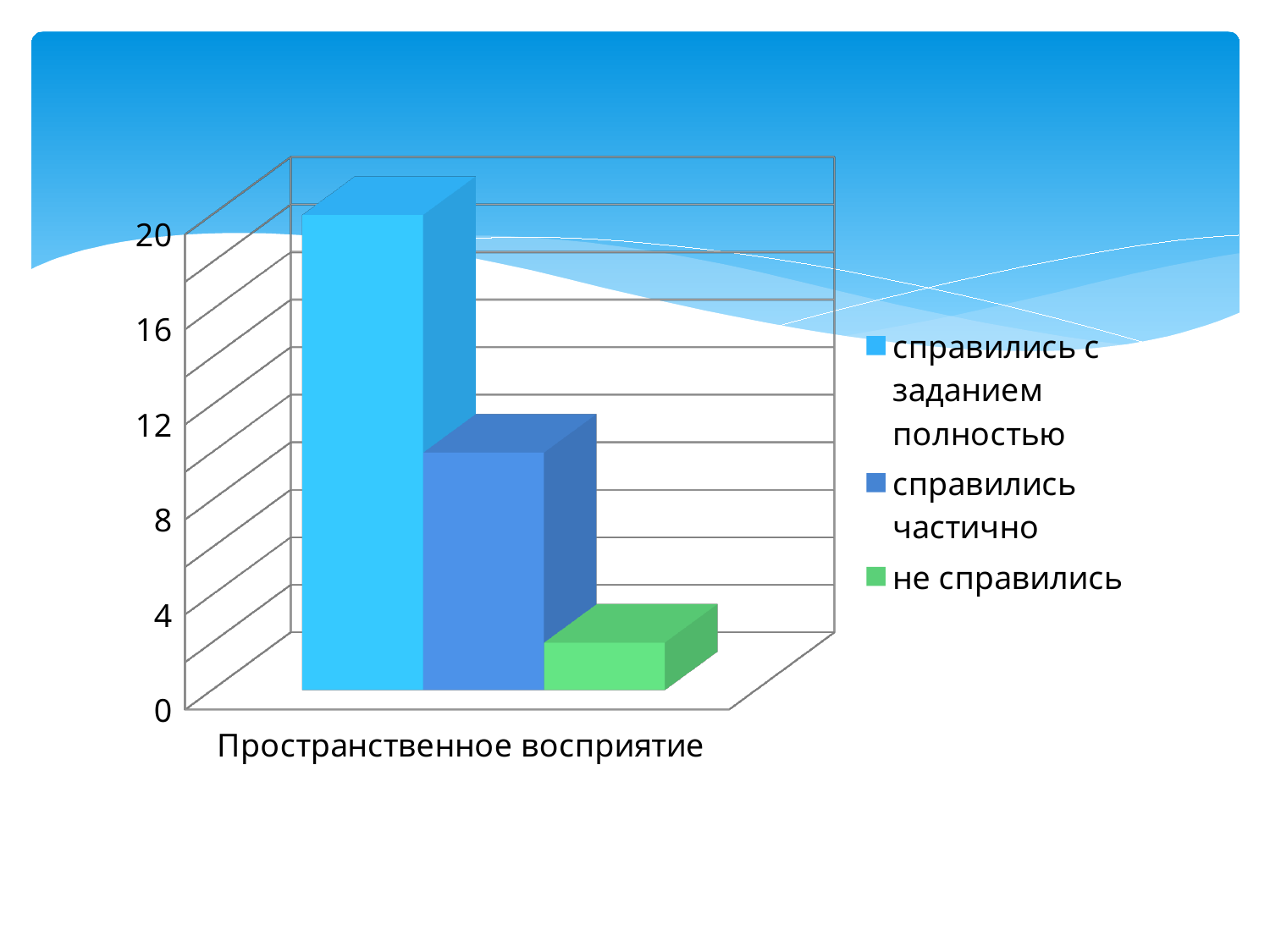
Is the value for "справились частично" greater or less than 12? less Which is larger: the value for "справились с заданием полностью" or the value for "справились частично"? справились с заданием полностью Which series has the lowest value? не справились What is the category label shown on the x axis? Пространственное восприятие How many categories are shown on the x axis? 1 How many series does the legend list? 3 Which is larger: the value for "справились частично" or the value for "не справились"? справились частично What kind of chart is shown on the slide? bar chart Is the value for "справились частично" greater or less than 8? greater Which series has the highest value? справились с заданием полностью Is the value for "справились с заданием полностью" greater or less than 16? greater